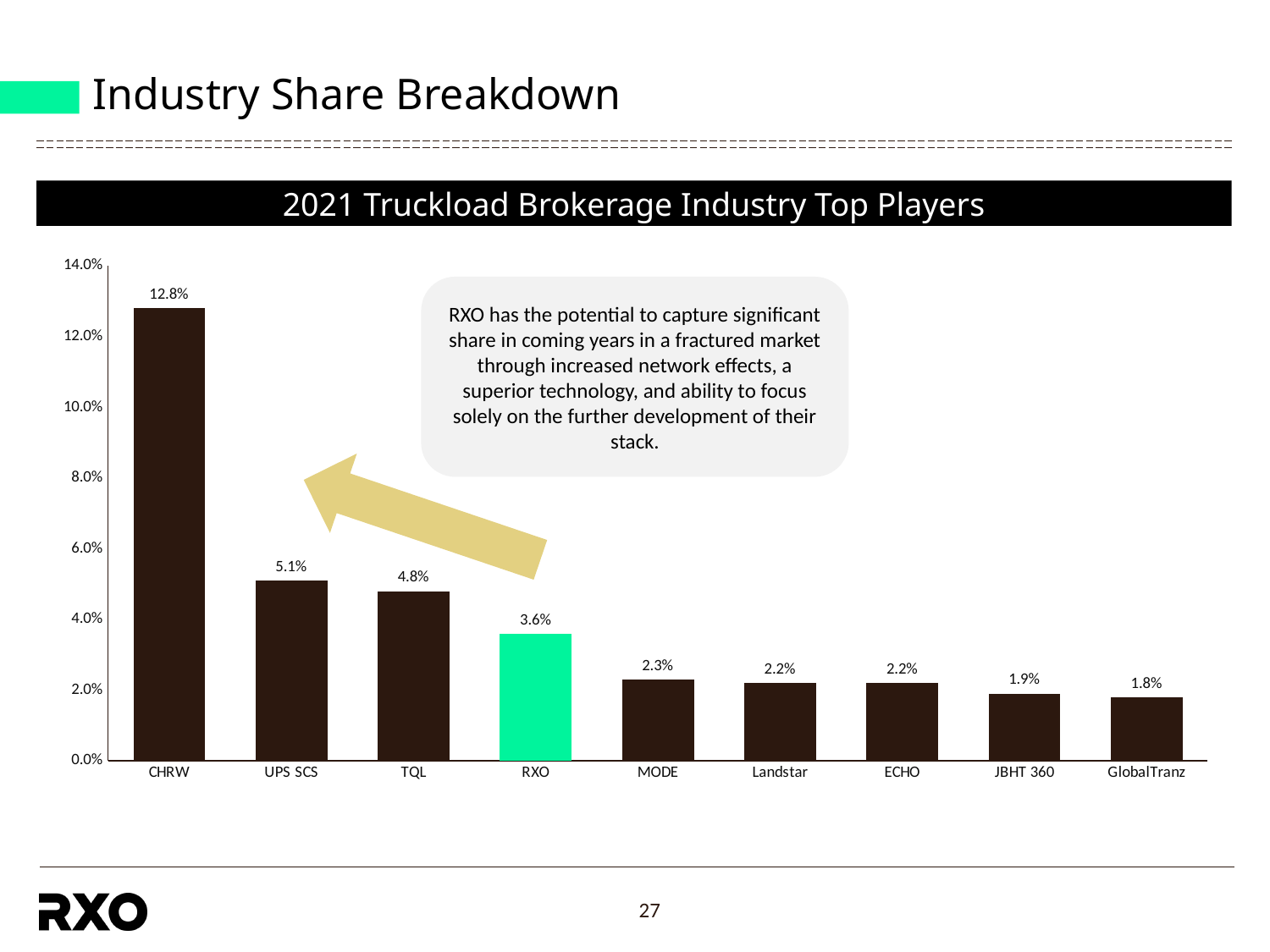
What is the value for RXO? 3.6% How many companies are shown on the chart? 9 What kind of chart is shown? Bar chart What is the title of the chart? 2021 Truckload Brokerage Industry Top Players Which company has the highest share? CHRW What is the value for GlobalTranz? 1.8% What is the difference between the values for CHRW and UPS SCS? 7.7% Which is larger, the value for UPS SCS or the value for TQL? UPS SCS Do the values rise or fall from left to right along the x axis? Fall What is the difference between the values for TQL and RXO? 1.2% Which company has the lowest share? GlobalTranz What is the value for CHRW? 12.8%